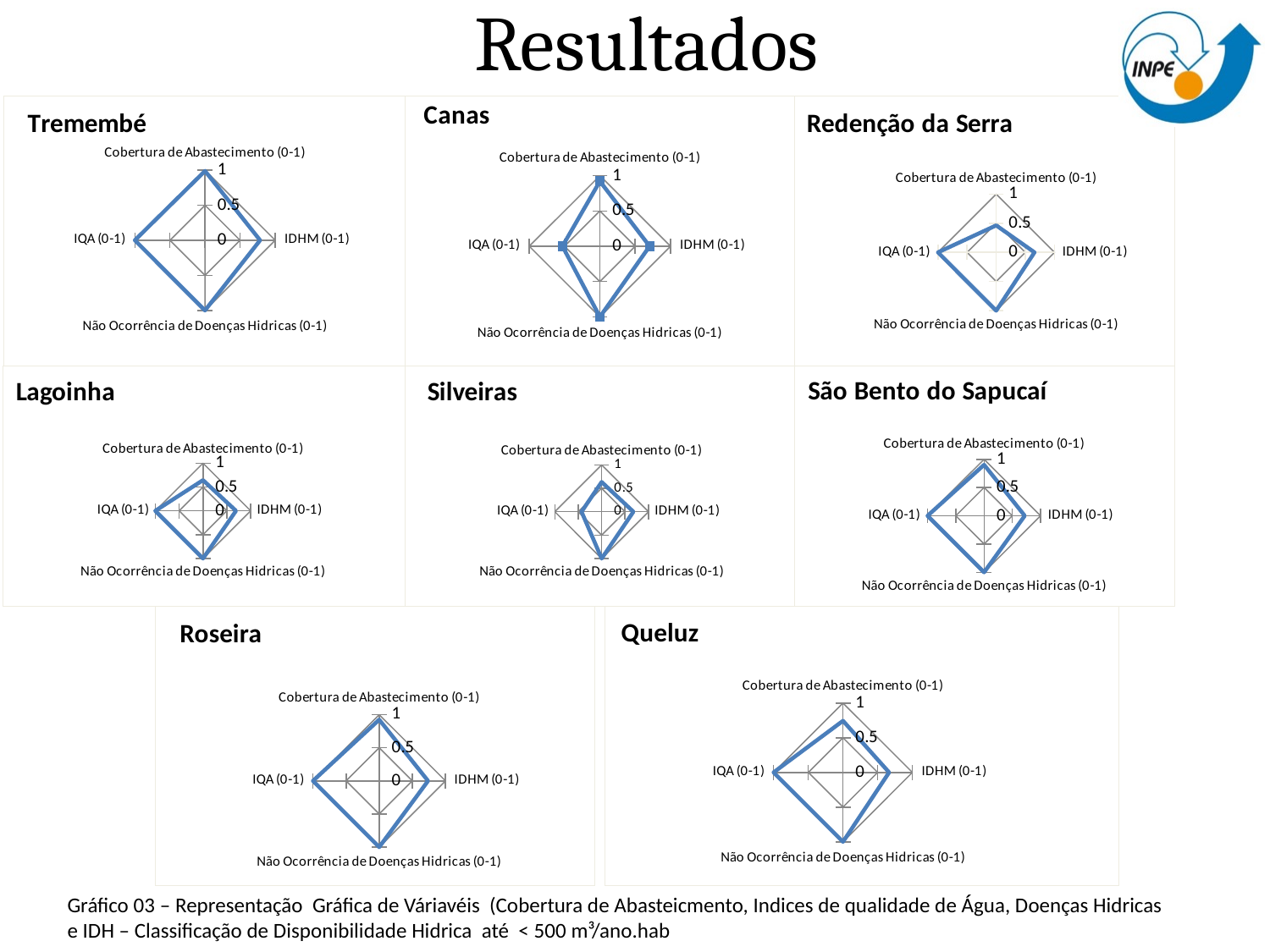
In the Redenção da Serra chart, is the value for Não Ocorrência de Doenças Hidricas (0-1) greater or less than 0.5? greater In the Queluz chart, is the value for Não Ocorrência de Doenças Hidricas (0-1) greater or less than 0.5? greater In the Silveiras chart, is the value for Cobertura de Abastecimento (0-1) greater or less than 0.5? greater Which variable is plotted on the top axis of the Roseira radar chart? Cobertura de Abastecimento (0-1) What is the maximum value shown on the axis scale of the São Bento do Sapucaí radar chart? 1 How many charts are shown on the slide? 8 How many variables (axes) does the Canas radar chart plot? 4 What kind of chart is used for Tremembé? Radar chart Which municipality's chart is shown in the top-right position of the slide? Redenção da Serra